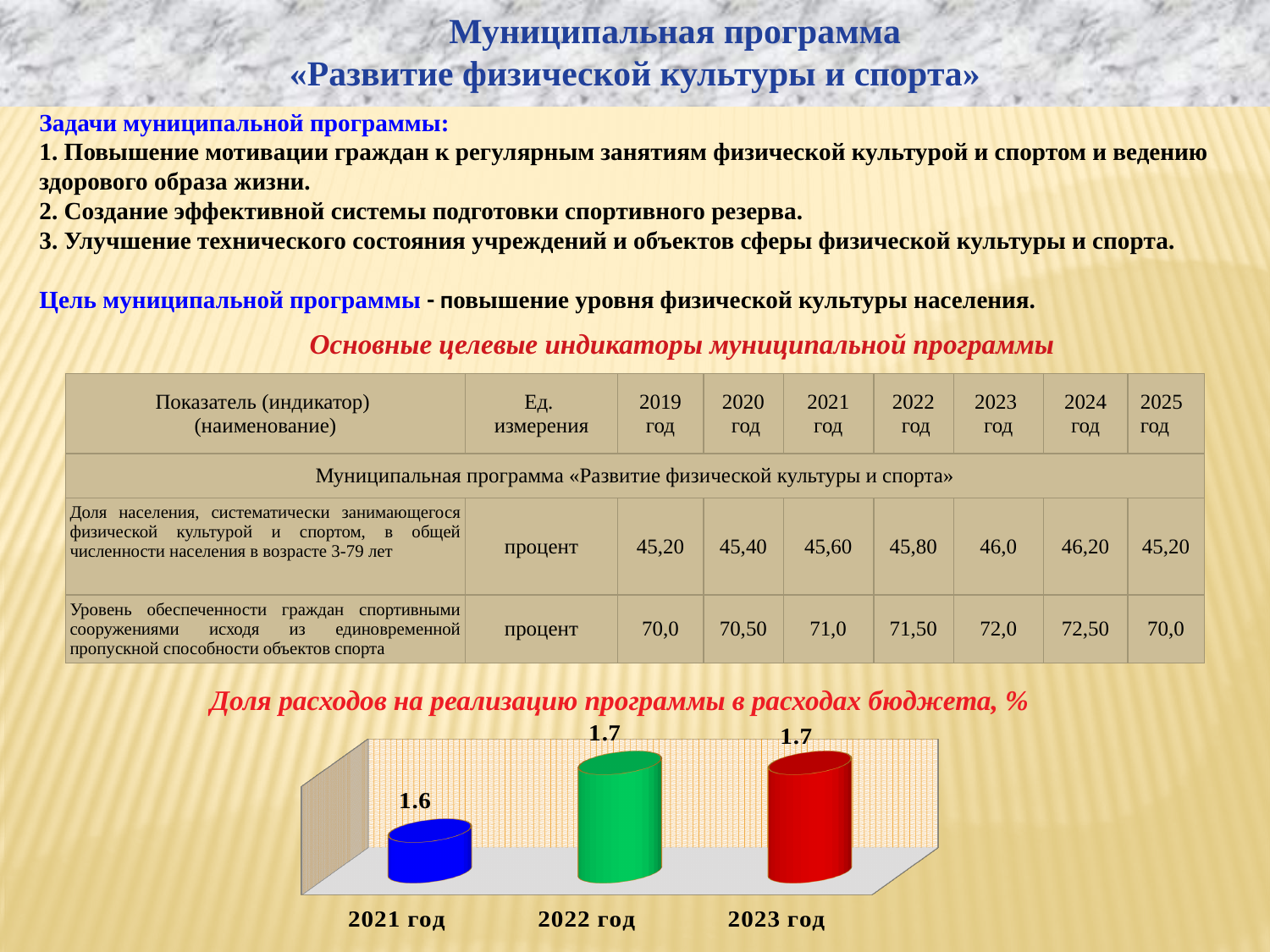
What is the value for 2022 год in the chart? 1.7 What is the value for 2023 год in the chart? 1.7 Which year has the lowest value in the chart? 2021 год How many years are shown in the chart? 3 What is the difference between the values for 2022 год and 2021 год? 0.1 What is the value for 2021 год in the chart? 1.6 What kind of chart is shown at the bottom of the slide? bar chart What is the title of the chart? Доля расходов на реализацию программы в расходах бюджета, % What colour is the bar for 2023 год? red Which is larger, the value for 2021 год or the value for 2022 год? 2022 год Does the value rise or fall from 2021 год to 2022 год? rise